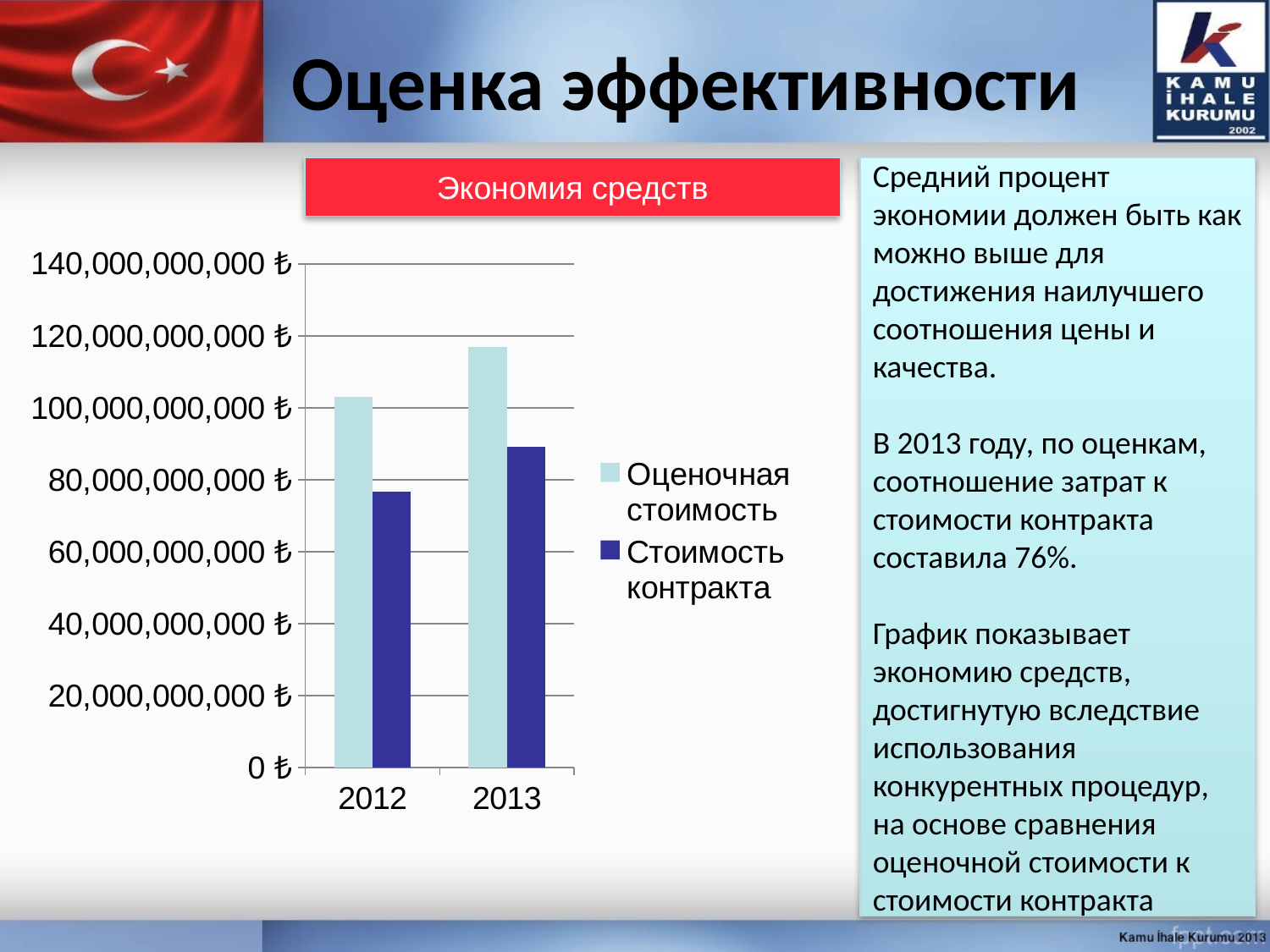
Which is larger: Оценочная стоимость for 2012 or Оценочная стоимость for 2013? 2013 How many series does the chart legend list? 2 Is the value of Оценочная стоимость for 2013 greater or less than 120,000,000,000 ₺? less Is the value of Оценочная стоимость for 2013 greater or less than 100,000,000,000 ₺? greater What is the title of the chart? Экономия средств What kind of chart is shown under the heading "Экономия средств"? bar chart Which bar is the highest in the chart? Оценочная стоимость for 2013 Which bar is the lowest in the chart? Стоимость контракта for 2012 Which series is shown in dark blue in the chart? Стоимость контракта Is the value of Стоимость контракта for 2013 greater or less than 80,000,000,000 ₺? greater How many years are shown on the x axis of the chart? 2 Does Стоимость контракта rise or fall from 2012 to 2013? rise